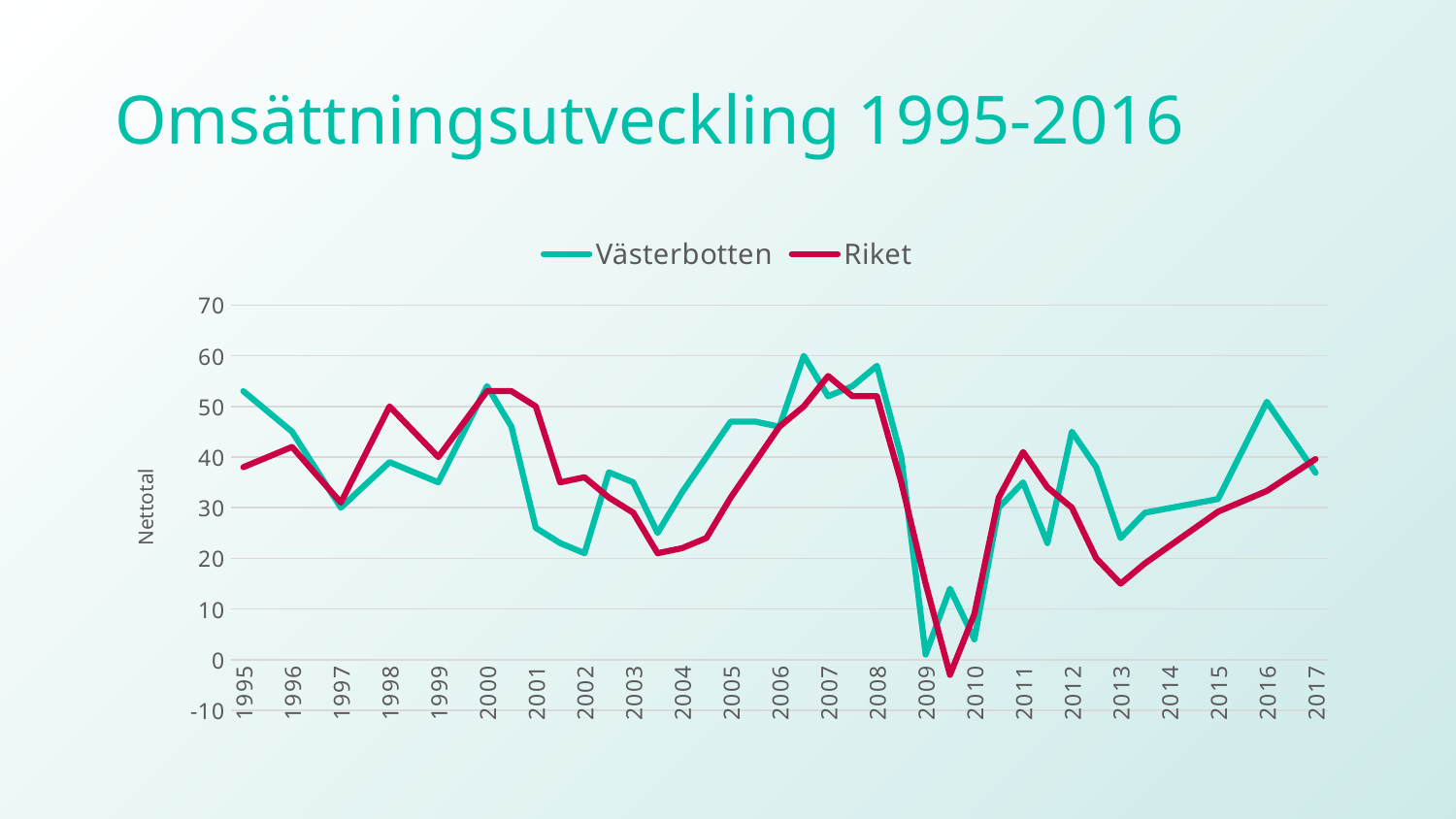
In which year does the Västerbotten line reach its lowest value? 2009 What is the title of the chart? Omsättningsutveckling 1995-2016 What kind of chart is shown on the slide? line chart How many series does the legend list? 2 Is the value for Västerbotten at 2016 greater or less than 40? greater In which year does the Västerbotten line reach its highest value? 2006 Does the Riket line rise or fall between 2013 and 2016? rise What is the label on the vertical axis? Nettotal Is the value for Riket at 2013 greater or less than 20? less Which series has the larger value at 2001, Västerbotten or Riket? Riket Which series has the larger value at 2016, Västerbotten or Riket? Västerbotten Is the value for Västerbotten at 2007 greater or less than 50? greater